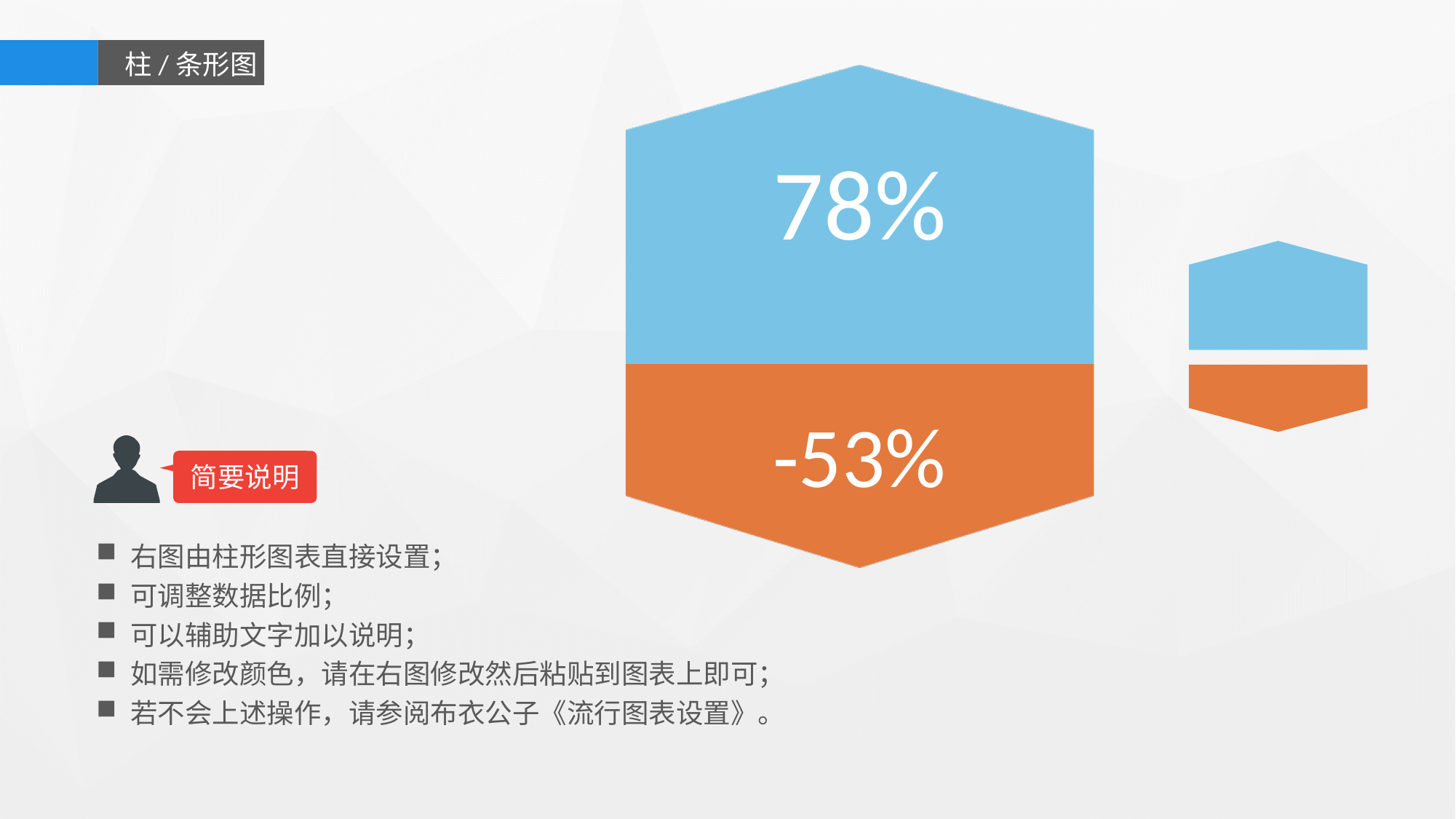
What value is printed on the orange segment of the hexagon chart? -53% What value is printed on the blue segment of the hexagon chart? 78% Which segment of the hexagon chart has the lowest value? the orange segment (-53%) Which segment of the hexagon chart shows the higher value, the blue one or the orange one? the blue one What colour is the segment labelled 78% in the hexagon chart? blue What colour is the segment labelled -53% in the hexagon chart? orange How many data segments are shown in the hexagon chart? 2 Is the value on the blue segment of the hexagon chart positive or negative? positive Which segment of the hexagon chart has the highest value? the blue segment (78%)